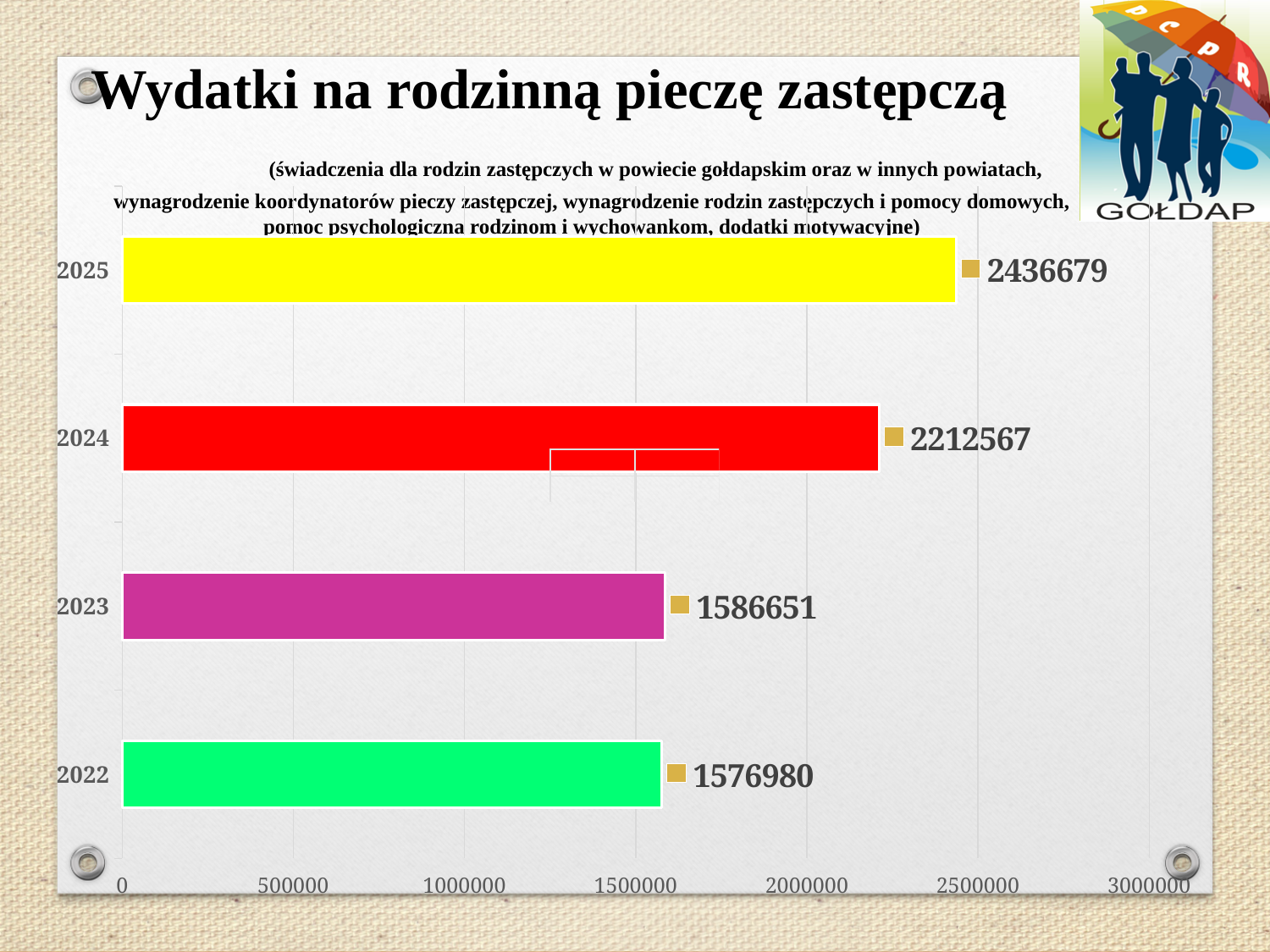
Is the value for 2024 greater or less than 2000000? greater What is the difference between the values for 2024 and 2023? 625916 Which is larger, the value for 2024 or the value for 2023? 2024 What is the value for 2022? 1576980 How many years are shown in the chart? 4 Which year has the lowest value? 2022 What is the difference between the values for 2025 and 2024? 224112 Which year has the highest value? 2025 What kind of chart is shown on the slide? bar chart What is the value for 2025? 2436679 What colour is the bar for 2024? red What is the value for 2023? 1586651